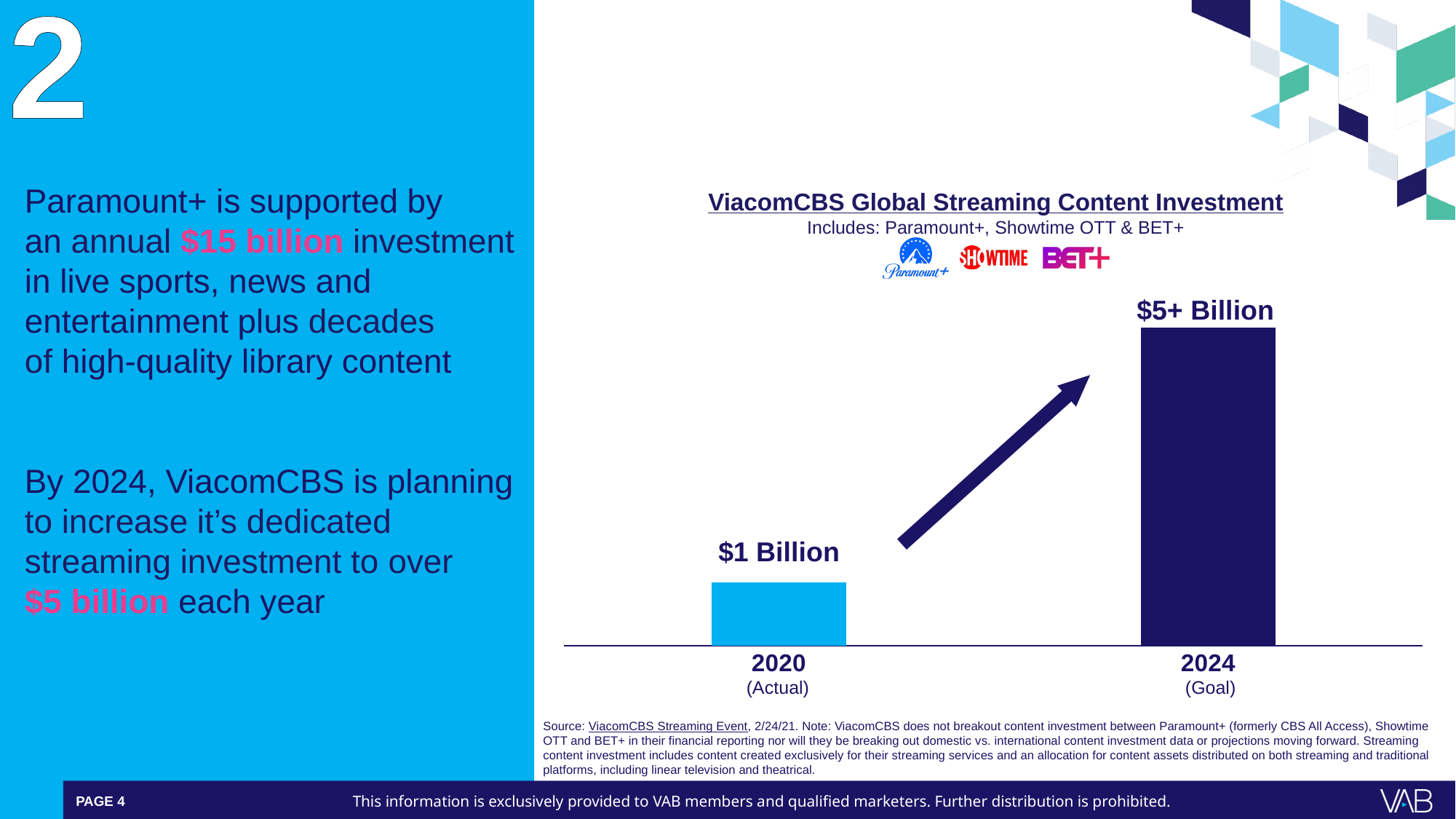
How many bars are plotted in the ViacomCBS Global Streaming Content Investment chart? 2 What is the title of the chart on the slide? ViacomCBS Global Streaming Content Investment What is the value shown for 2024 (Goal) in the ViacomCBS Global Streaming Content Investment chart? $5+ Billion Which category has the lowest value in the ViacomCBS Global Streaming Content Investment chart? 2020 (Actual) Which services does the chart subtitle say the investment includes? Paramount+, Showtime OTT & BET+ What kind of chart is the ViacomCBS Global Streaming Content Investment chart? Bar chart What is the value shown for 2020 (Actual) in the ViacomCBS Global Streaming Content Investment chart? $1 Billion Which category has the highest value in the ViacomCBS Global Streaming Content Investment chart? 2024 (Goal) Which year in the chart is labeled as the Goal? 2024 Do the values in the ViacomCBS Global Streaming Content Investment chart rise or fall from 2020 to 2024? Rise Which year has the higher streaming content investment in the chart, 2020 or 2024? 2024